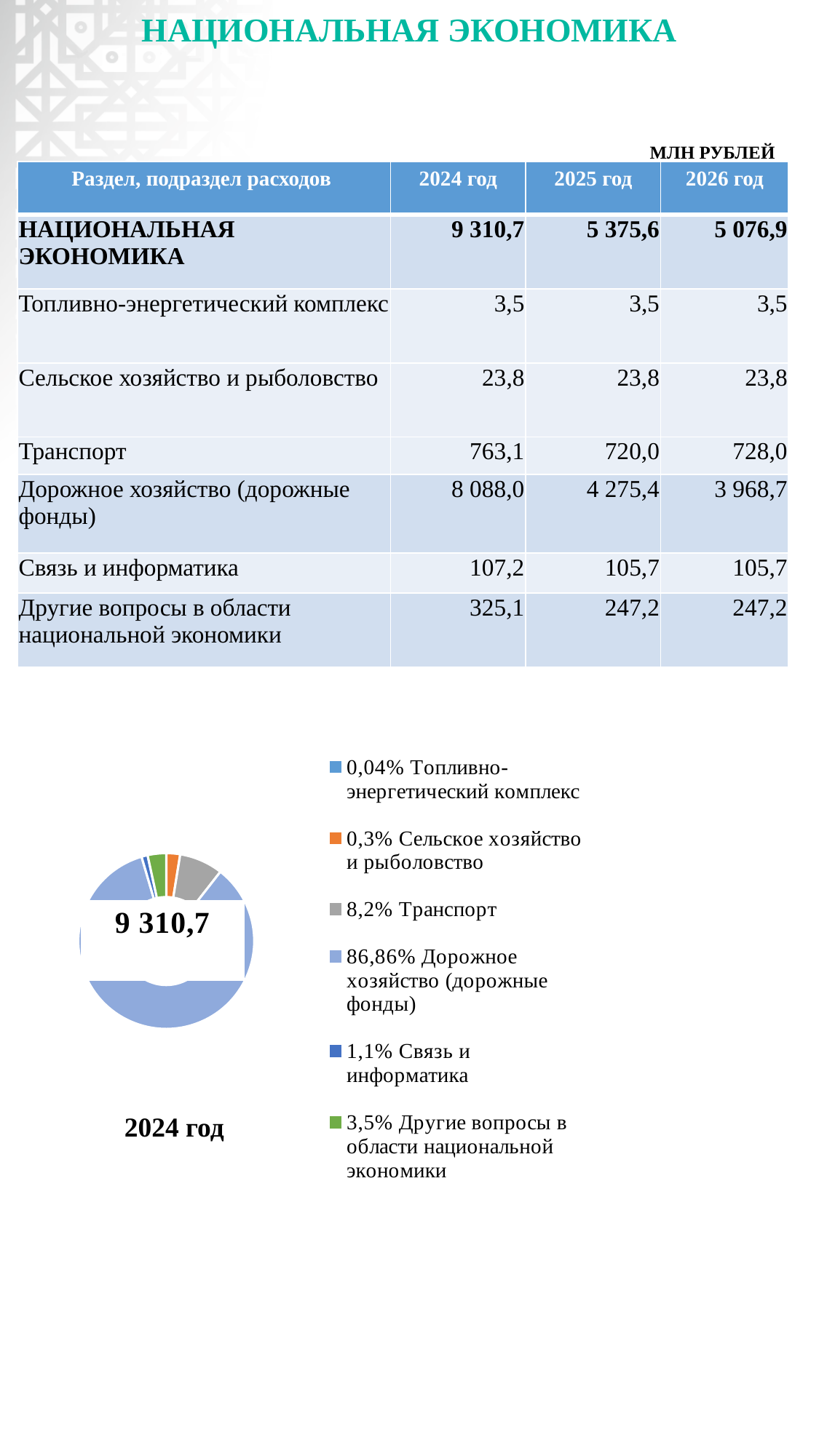
What share of the doughnut chart does Связь и информатика take? 1,1% In the doughnut chart, what is the difference in percentage points between the Транспорт share and the Другие вопросы в области национальной экономики share? 4,7% What share of the doughnut chart does Транспорт take? 8,2% What value is printed in the centre of the doughnut chart? 9 310,7 Which year does the doughnut chart represent, according to the label beneath it? 2024 год What kind of chart is shown at the bottom of the slide? Pie (doughnut) chart Which category has the largest slice in the doughnut chart? Дорожное хозяйство (дорожные фонды) How many slices (categories) does the doughnut chart have? 6 In the doughnut chart, which slice is larger: Транспорт or Другие вопросы в области национальной экономики? Транспорт What share of the doughnut chart does Дорожное хозяйство (дорожные фонды) take? 86,86% Which category has the smallest slice in the doughnut chart? Топливно-энергетический комплекс What colour is the Сельское хозяйство и рыболовство slice in the doughnut chart? Orange